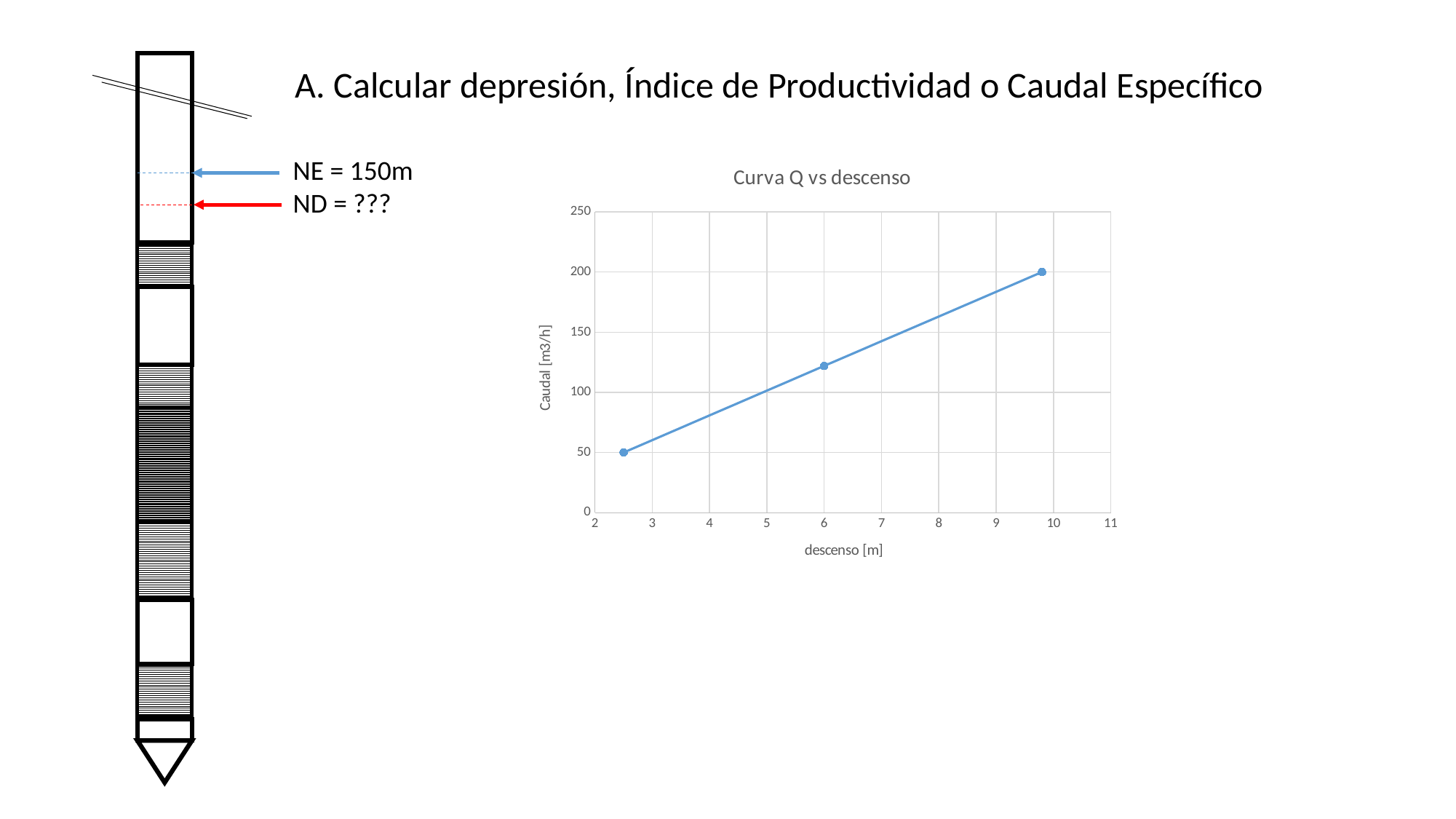
What is the label of the vertical axis on the "Curva Q vs descenso" chart? Caudal [m3/h] On the "Curva Q vs descenso" chart, is the Caudal value of the leftmost data point greater or less than 100? less What kind of chart is "Curva Q vs descenso"? line chart On the "Curva Q vs descenso" chart, is the Caudal value of the middle data point greater or less than 150? less How many data points are plotted on the "Curva Q vs descenso" chart? 3 On the "Curva Q vs descenso" chart, which data point has the lowest Caudal: the leftmost, the middle, or the rightmost? the leftmost On the "Curva Q vs descenso" chart, does the Caudal rise or fall as descenso increases? rise On the "Curva Q vs descenso" chart, which data point has the highest Caudal: the leftmost, the middle, or the rightmost? the rightmost On the "Curva Q vs descenso" chart, is the Caudal value of the rightmost data point greater or less than 150? greater What is the title of the chart on the slide? Curva Q vs descenso